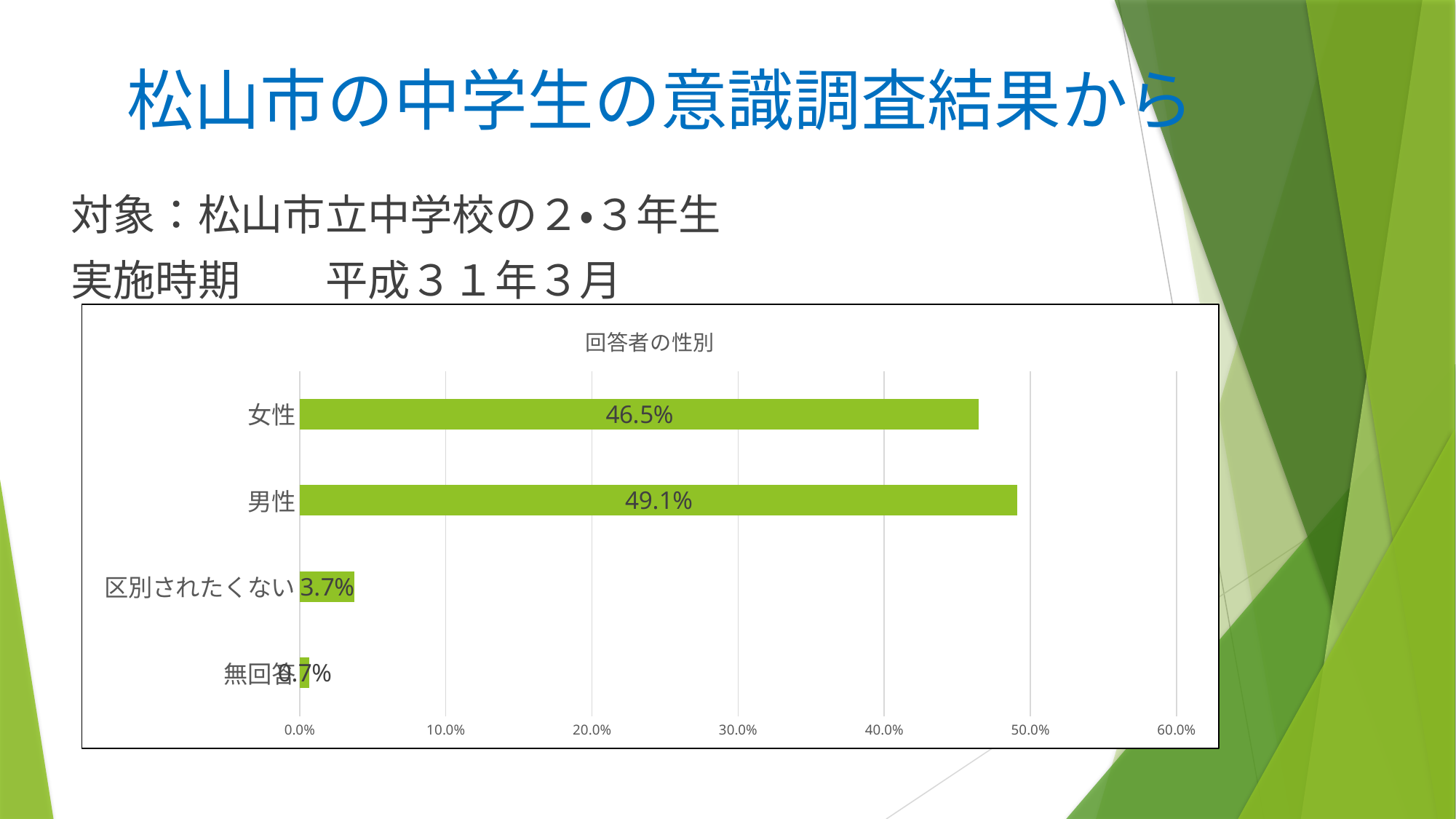
What is the value for 女性? 46.5% Is the value for 無回答 greater or less than 10.0%? less Which category has the highest value? 男性 Which is larger, the value for 女性 or the value for 区別されたくない? 女性 What type of chart is shown on the slide? bar chart What is the difference between the values for 女性 and 区別されたくない? 42.8% Which category has the lowest value? 無回答 What is the value for 男性? 49.1% What is the value for 区別されたくない? 3.7% What is the title of the chart? 回答者の性別 What is the difference between the values for 男性 and 女性? 2.6% How many categories are shown in the chart? 4